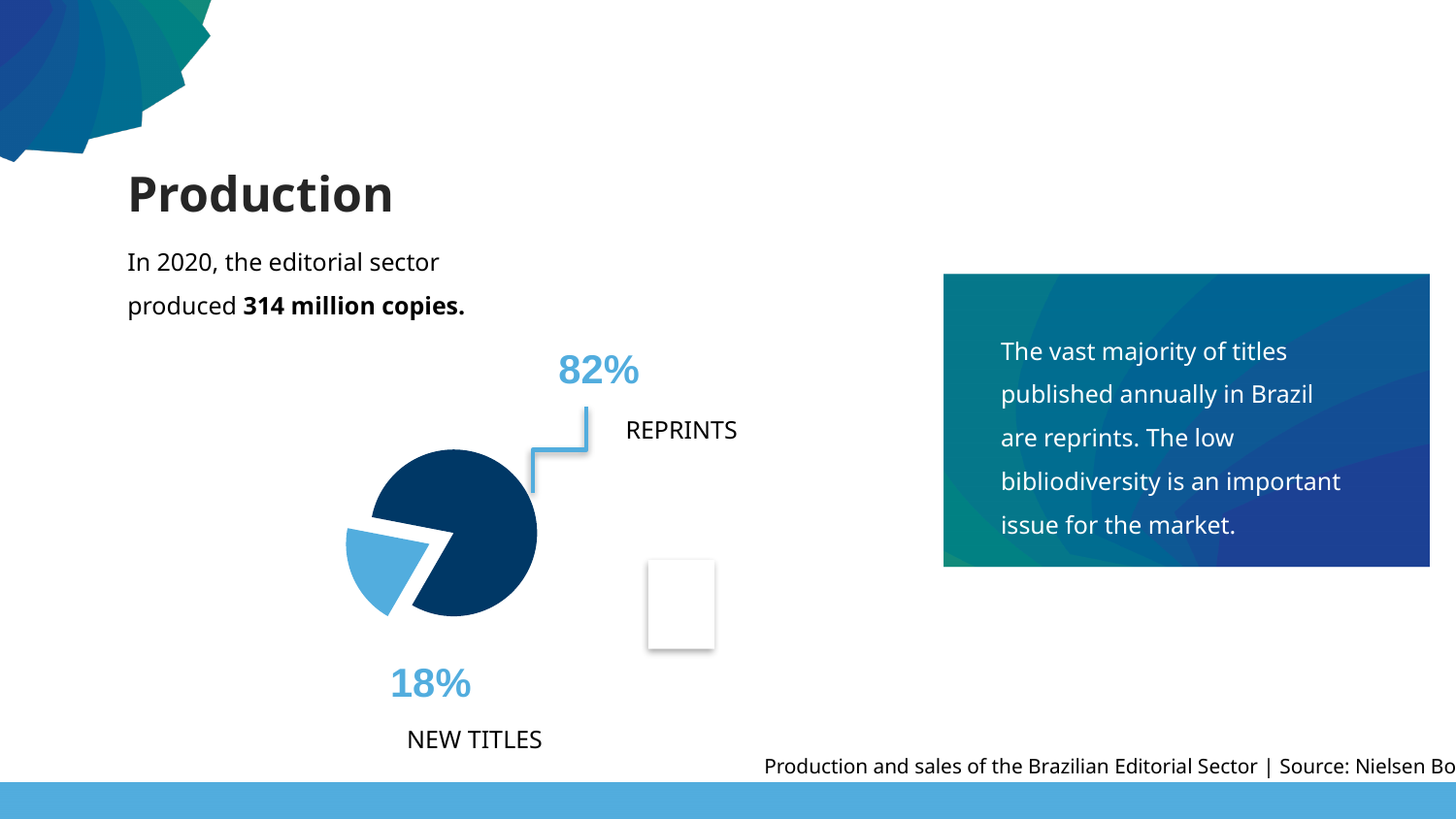
What is the difference in percentage points between the REPRINTS and NEW TITLES slices? 64 What share of the pie chart is labelled NEW TITLES? 18% Which slice of the pie chart is the largest? REPRINTS What kind of chart is shown on the slide? pie chart How many slices does the pie chart have? 2 Which is larger, the REPRINTS slice or the NEW TITLES slice? REPRINTS What is the combined share of the REPRINTS and NEW TITLES slices? 100% What colour is the NEW TITLES slice of the pie chart? light blue What share of the pie chart is labelled REPRINTS? 82% What colour is the REPRINTS slice of the pie chart? dark blue Which slice of the pie chart is the smallest? NEW TITLES